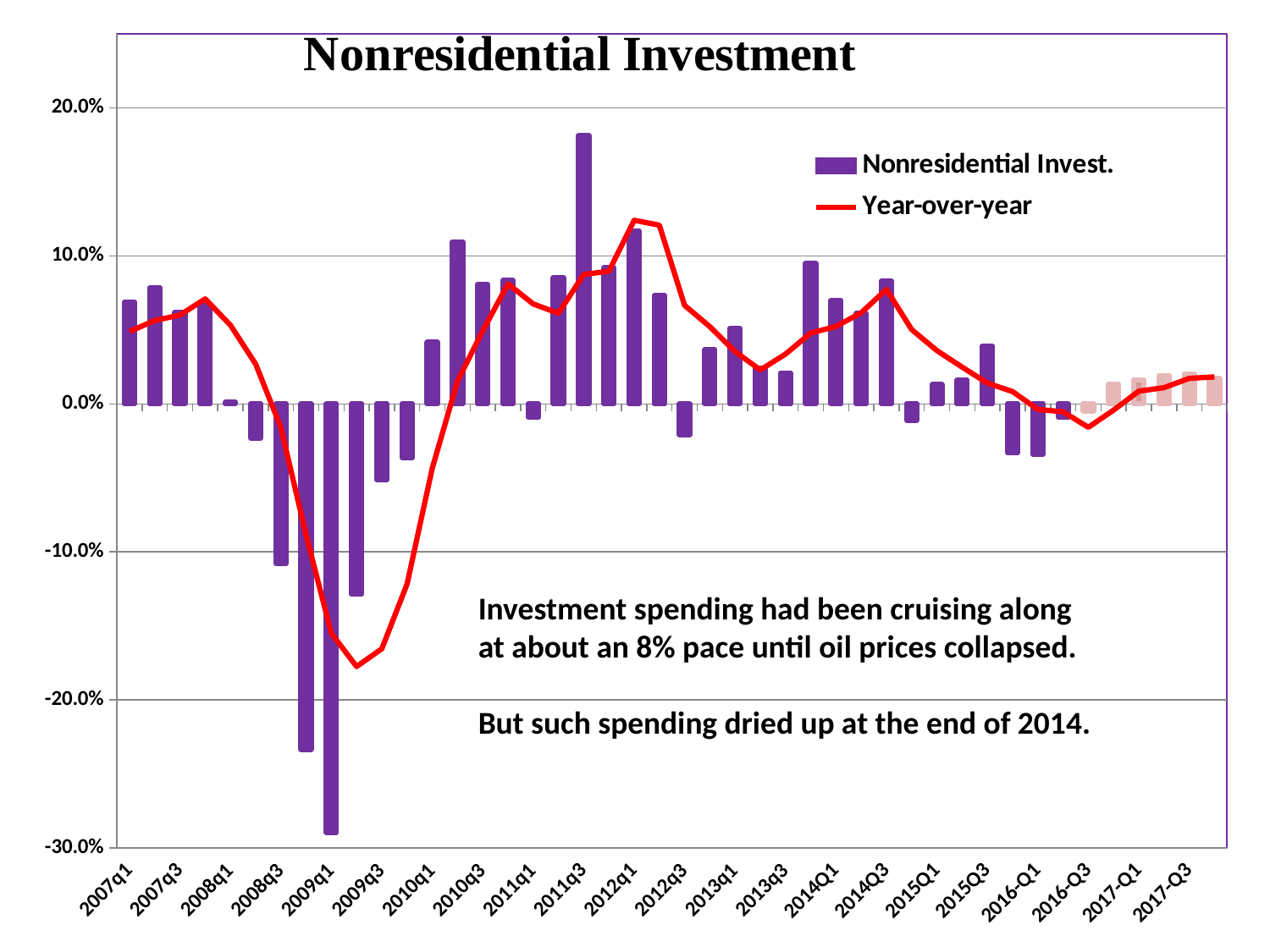
Do the Nonresidential Invest. bars rise or fall from 2008q1 to 2009q1? fall Which quarter has the lowest Nonresidential Invest. bar? 2009q1 Is the Nonresidential Invest. value for 2011q3 greater or less than 10.0%? greater What kind of chart is this? Bar chart with a line Which quarter has the highest Nonresidential Invest. bar? 2011q3 What is the title of the chart? Nonresidential Investment What are the two series named in the legend? Nonresidential Invest. and Year-over-year Which is larger, the Nonresidential Invest. bar for 2011q3 or for 2010q3? 2011q3 How many series does the legend list? 2 Is the Nonresidential Invest. value for 2009q1 greater or less than -20.0%? less Is the Year-over-year value at 2012q1 greater or less than 10.0%? greater